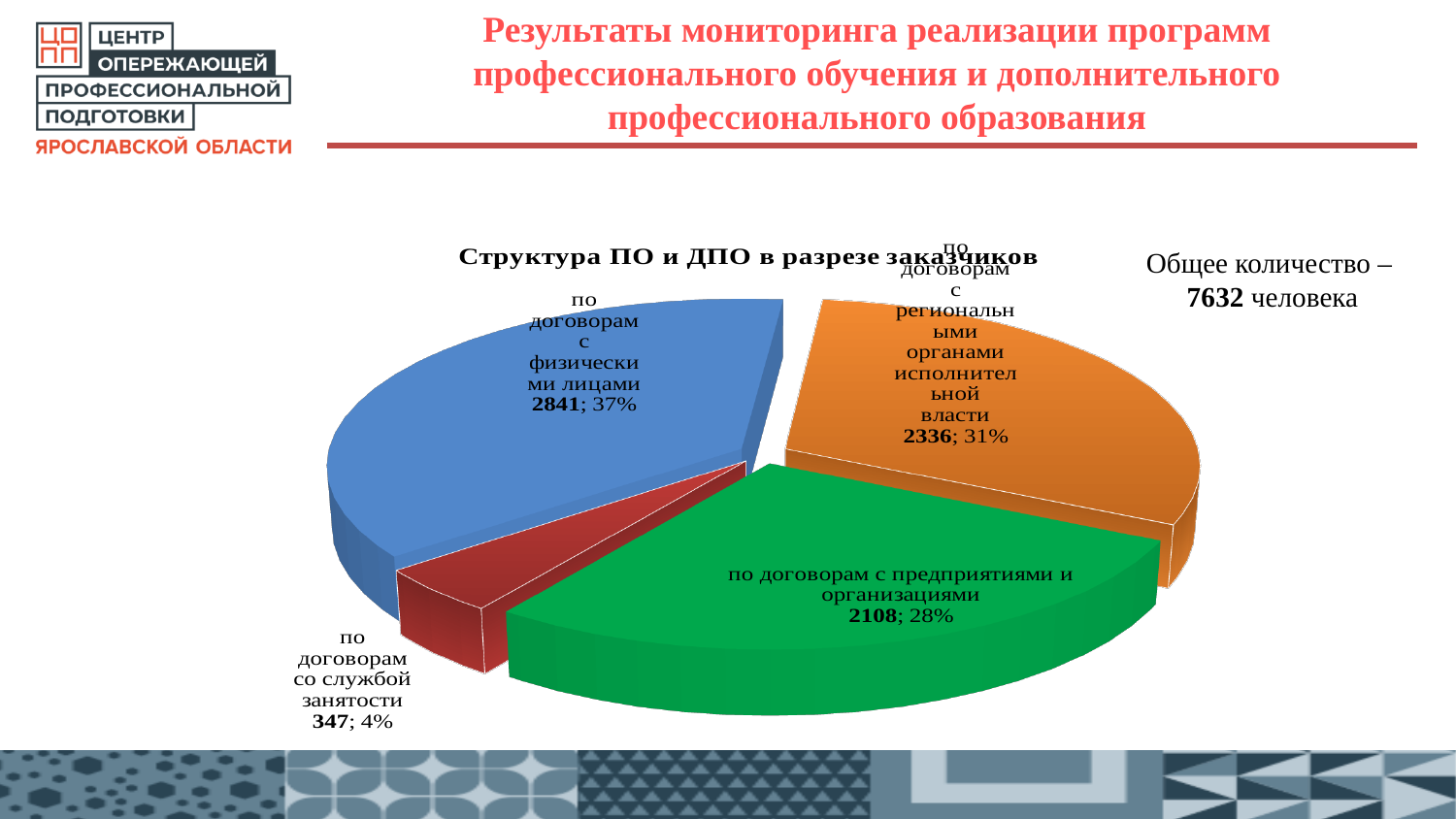
What is the value for "по договорам с предприятиями и организациями"? 2108 What is the value for "по договорам с физическими лицами"? 2841 Which is larger: the value for "по договорам с региональными органами исполнительной власти" or "по договорам с предприятиями и организациями"? по договорам с региональными органами исполнительной власти What is the difference between the values for "по договорам с физическими лицами" and "по договорам с предприятиями и организациями"? 733 Which category has the largest slice? по договорам с физическими лицами How many slices does the pie chart have? 4 What share of the pie does "по договорам с региональными органами исполнительной власти" represent? 31% What share of the pie does "по договорам со службой занятости" represent? 4% What kind of chart is shown on the slide? pie chart Which category has the smallest slice? по договорам со службой занятости What is the value for "по договорам со службой занятости"? 347 What is the title of the chart? Структура ПО и ДПО в разрезе заказчиков